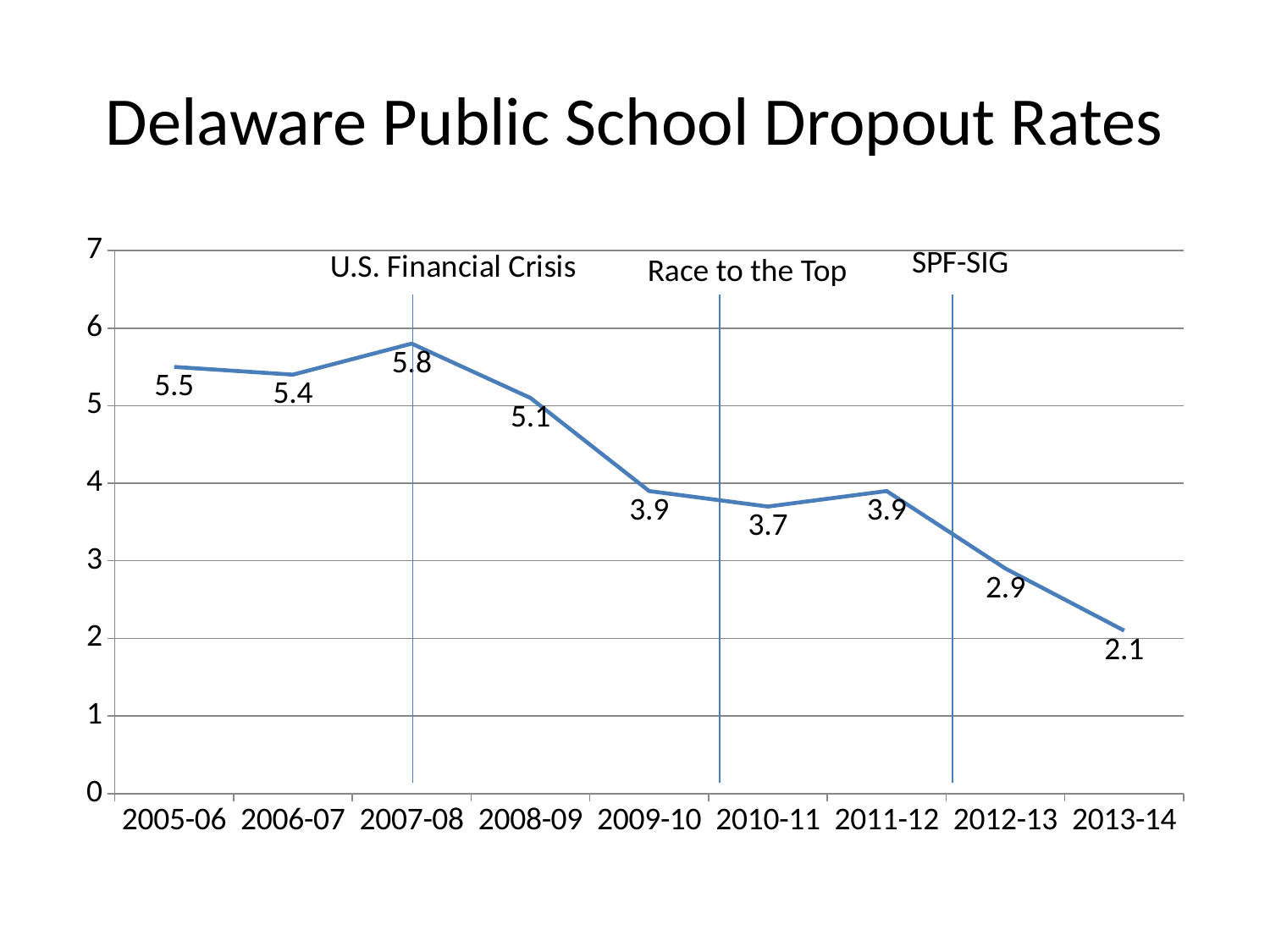
What is the dropout rate for 2007-08? 5.8 How many school years are plotted on the chart? 9 What is the difference between the dropout rates for 2008-09 and 2009-10? 1.2 Which school year has the highest dropout rate? 2007-08 What is the title of the chart? Delaware Public School Dropout Rates What kind of chart is shown on the slide? line chart What is the difference between the dropout rates for 2007-08 and 2013-14? 3.7 What is the dropout rate for 2010-11? 3.7 Which is larger, the dropout rate for 2005-06 or for 2006-07? 2005-06 What is the dropout rate for 2013-14? 2.1 Is the dropout rate for 2012-13 greater or less than 3? less Which school year has the lowest dropout rate? 2013-14